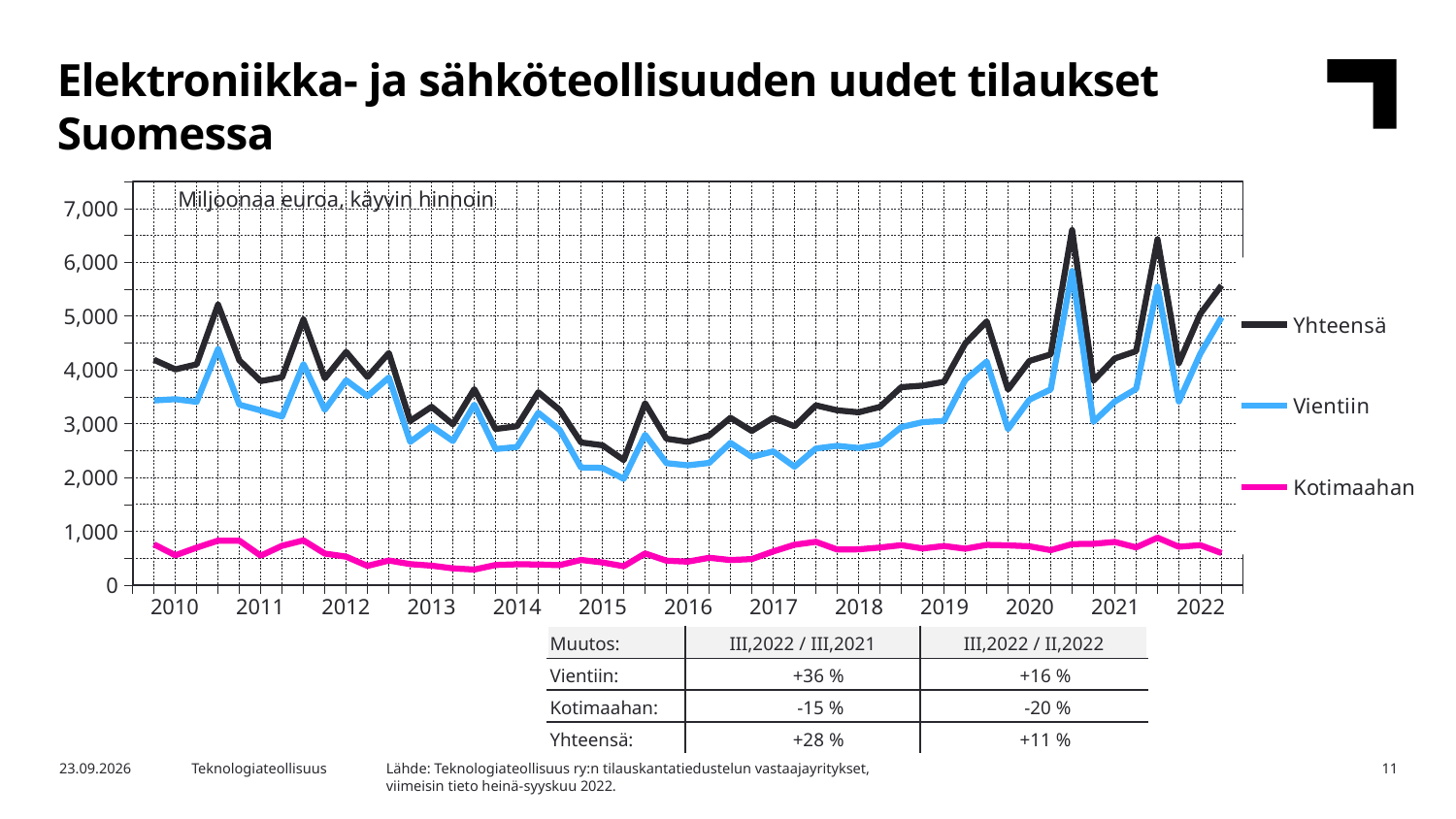
How many year labels are shown on the x axis? 13 What kind of chart is shown on the slide? line chart What unit is stated in the label at the top of the chart area? Miljoonaa euroa, käyvin hinnoin What are the three series named in the chart's legend? Yhteensä, Vientiin, Kotimaahan Is the peak value for Yhteensä in 2020 greater or less than 6,000? greater Is the value for Kotimaahan in 2015 greater or less than 1,000? less According to the table below the chart, what is the change for Vientiin in III,2022 / III,2021? +36 % Which series has the lowest values throughout the chart? Kotimaahan Which series is larger in 2018, Vientiin or Kotimaahan? Vientiin How many series does the chart's legend list? 3 Which series has the highest values throughout the chart? Yhteensä Is the value for Vientiin in 2015 greater or less than 3,000? less